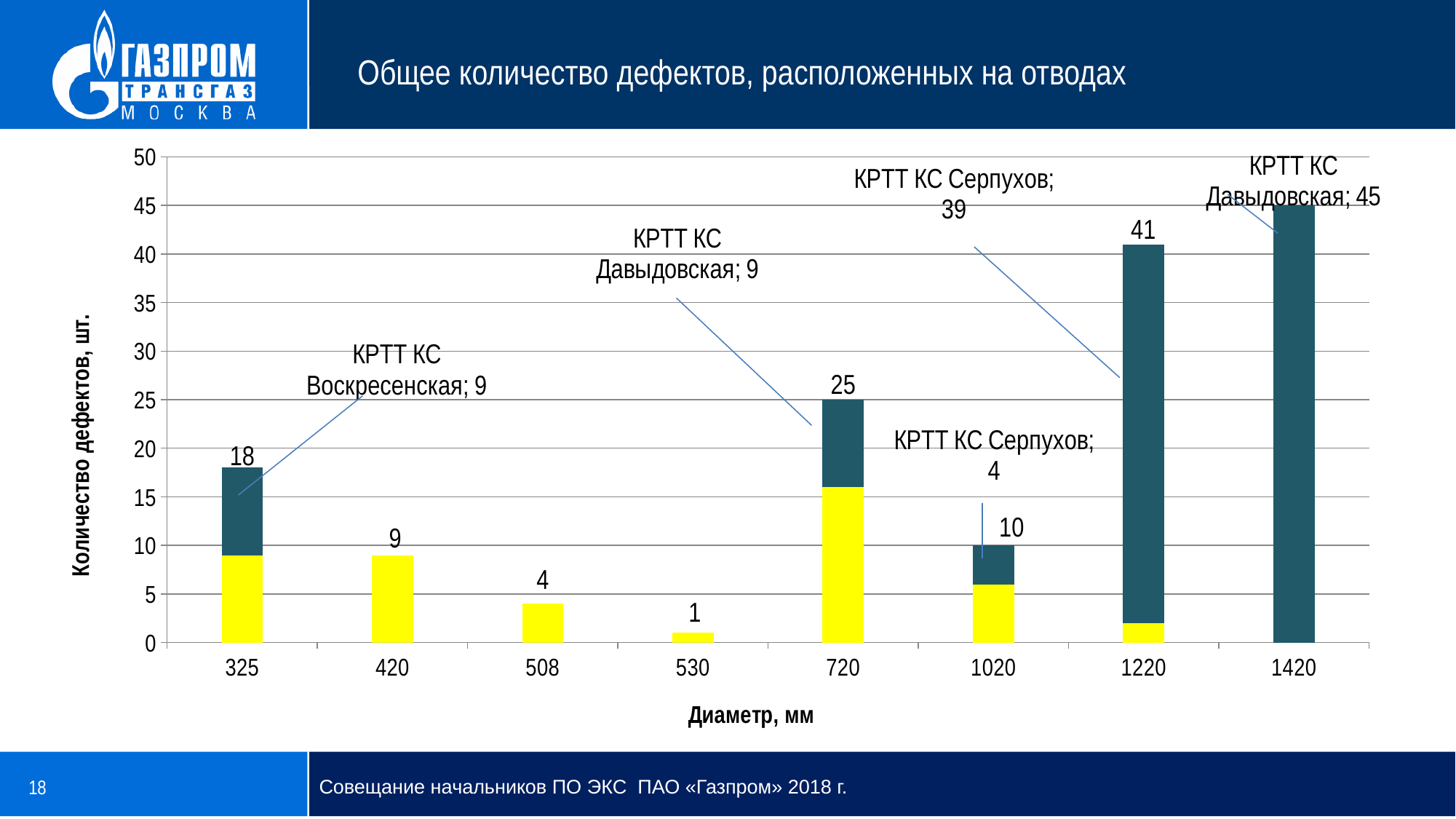
What is the title of the chart on the slide? Общее количество дефектов, расположенных на отводах What is the label of the vertical axis? Количество дефектов, шт. How many defects does the callout attribute to КРТТ КС Серпухов for diameter 1220 mm? 39 How many diameter categories are shown on the x axis? 8 Which diameter has more total defects, 325 mm or 1020 mm? 325 What kind of chart is shown on the slide? Bar chart Which diameter has the lowest total number of defects? 530 Is the total value for diameter 720 mm greater or less than 20? greater What is the difference between the total defects for diameter 1420 mm and diameter 1220 mm? 4 What is the total number of defects shown for diameter 1220 mm? 41 What is the total number of defects shown for diameter 720 mm? 25 Which diameter has the highest total number of defects? 1420